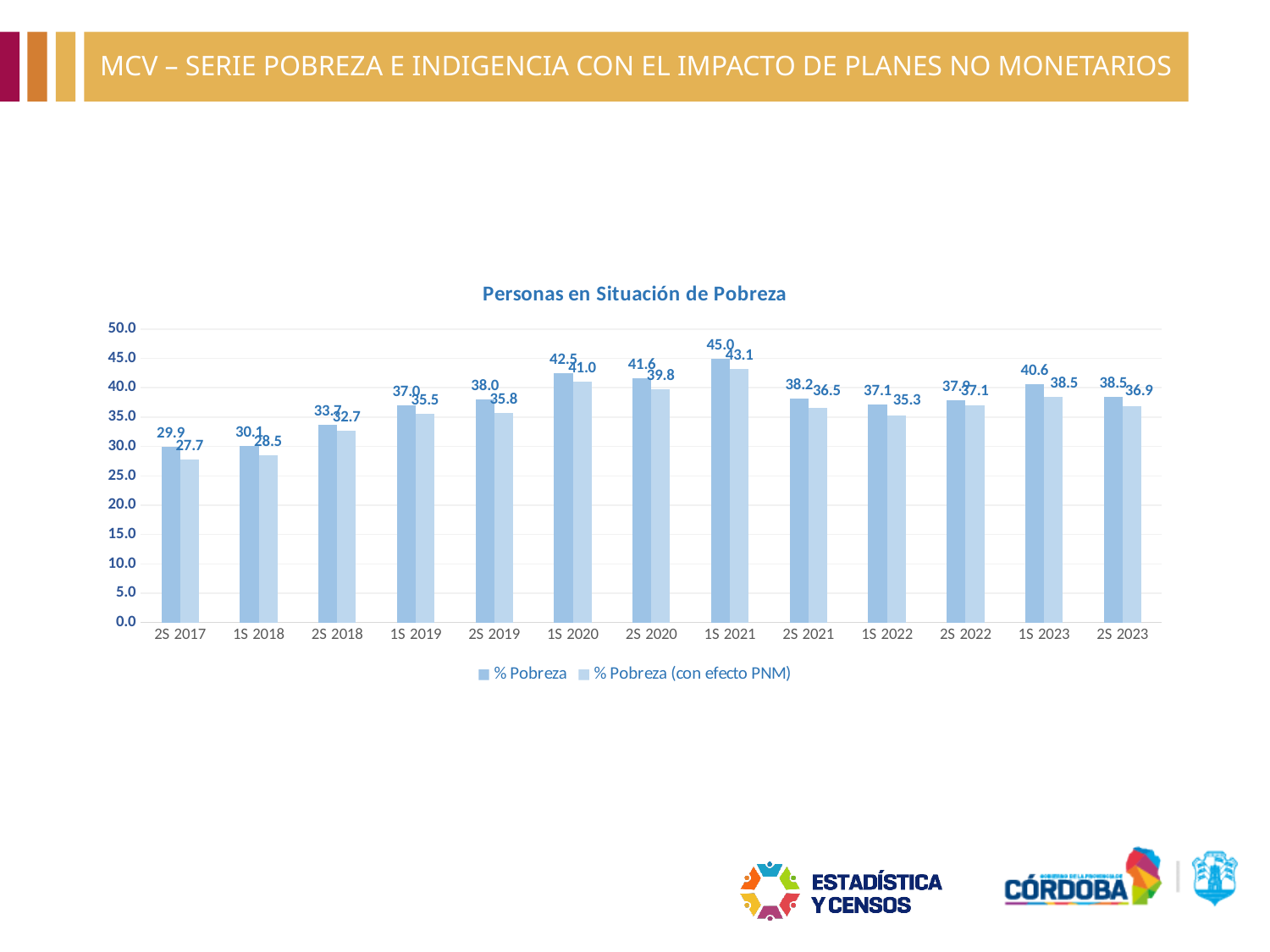
What kind of chart is shown on the slide? bar chart What is the difference between % Pobreza and % Pobreza (con efecto PNM) in 1S 2021? 1.9 What is the % Pobreza value for 1S 2021? 45.0 Which period has the highest % Pobreza value? 1S 2021 What is the difference between % Pobreza and % Pobreza (con efecto PNM) in 2S 2017? 2.2 Which period has the lowest % Pobreza (con efecto PNM) value? 2S 2017 Which is larger, the % Pobreza value for 1S 2020 or for 2S 2020? 1S 2020 Is the % Pobreza value for 1S 2023 greater or less than 40.0? greater How many periods are shown on the x axis? 13 What is the % Pobreza (con efecto PNM) value for 2S 2023? 36.9 How many series does the legend list? 2 What is the % Pobreza (con efecto PNM) value for 1S 2022? 35.3